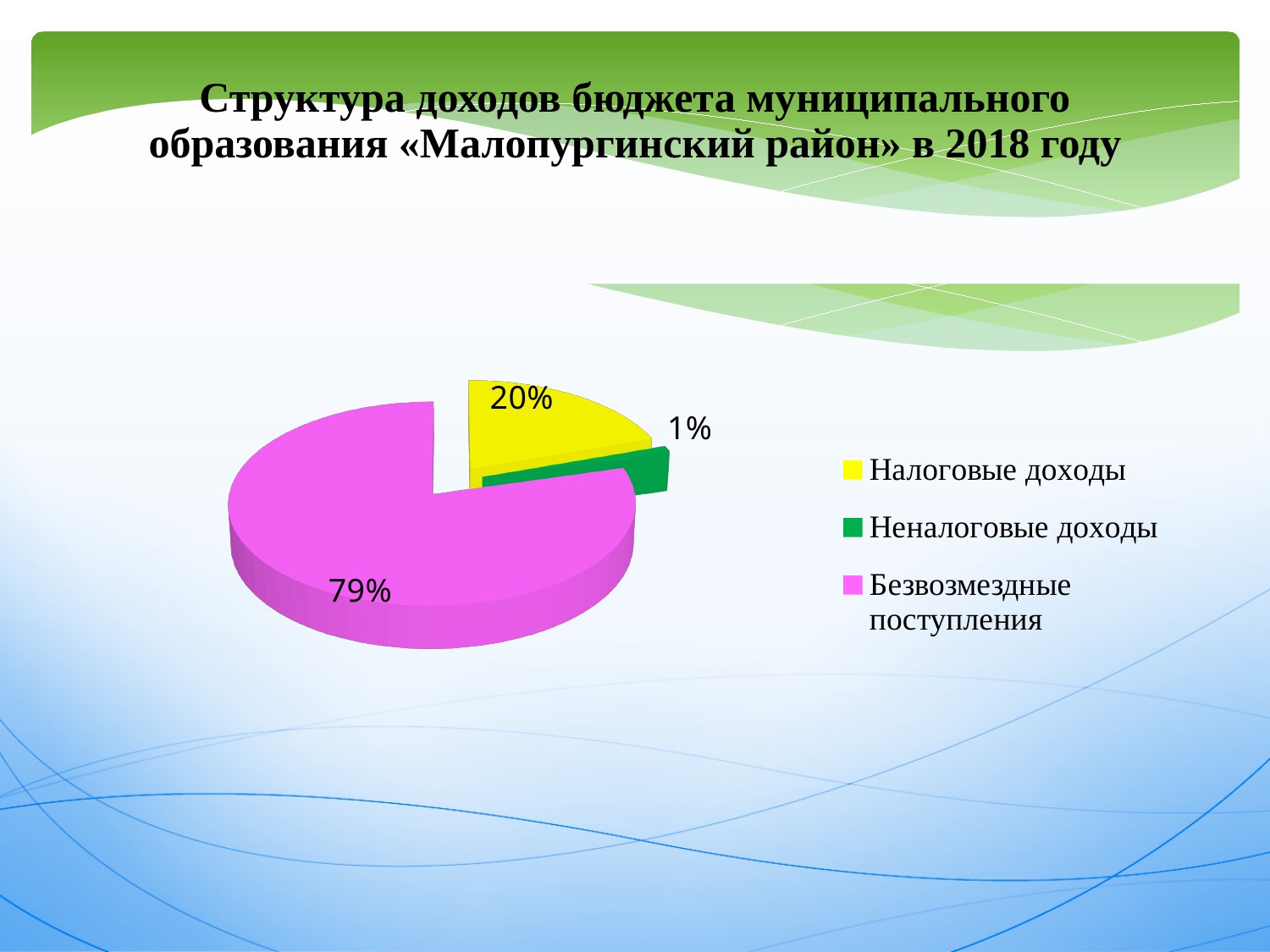
What kind of chart is shown on the slide? Pie chart What share of the pie does Безвозмездные поступления have? 79% What share of the pie does Налоговые доходы have? 20% What is the title of the slide containing the chart? Структура доходов бюджета муниципального образования «Малопургинский район» в 2018 году What is the difference in percentage points between Налоговые доходы and Неналоговые доходы? 19 What share of the pie does Неналоговые доходы have? 1% Which category has the largest share of the pie? Безвозмездные поступления Which category has the smallest share of the pie? Неналоговые доходы Which is larger, the share for Налоговые доходы or the share for Неналоговые доходы? Налоговые доходы What is the difference in percentage points between Безвозмездные поступления and Налоговые доходы? 59 What colour is the slice for Безвозмездные поступления? Pink How many categories does the pie chart have? 3